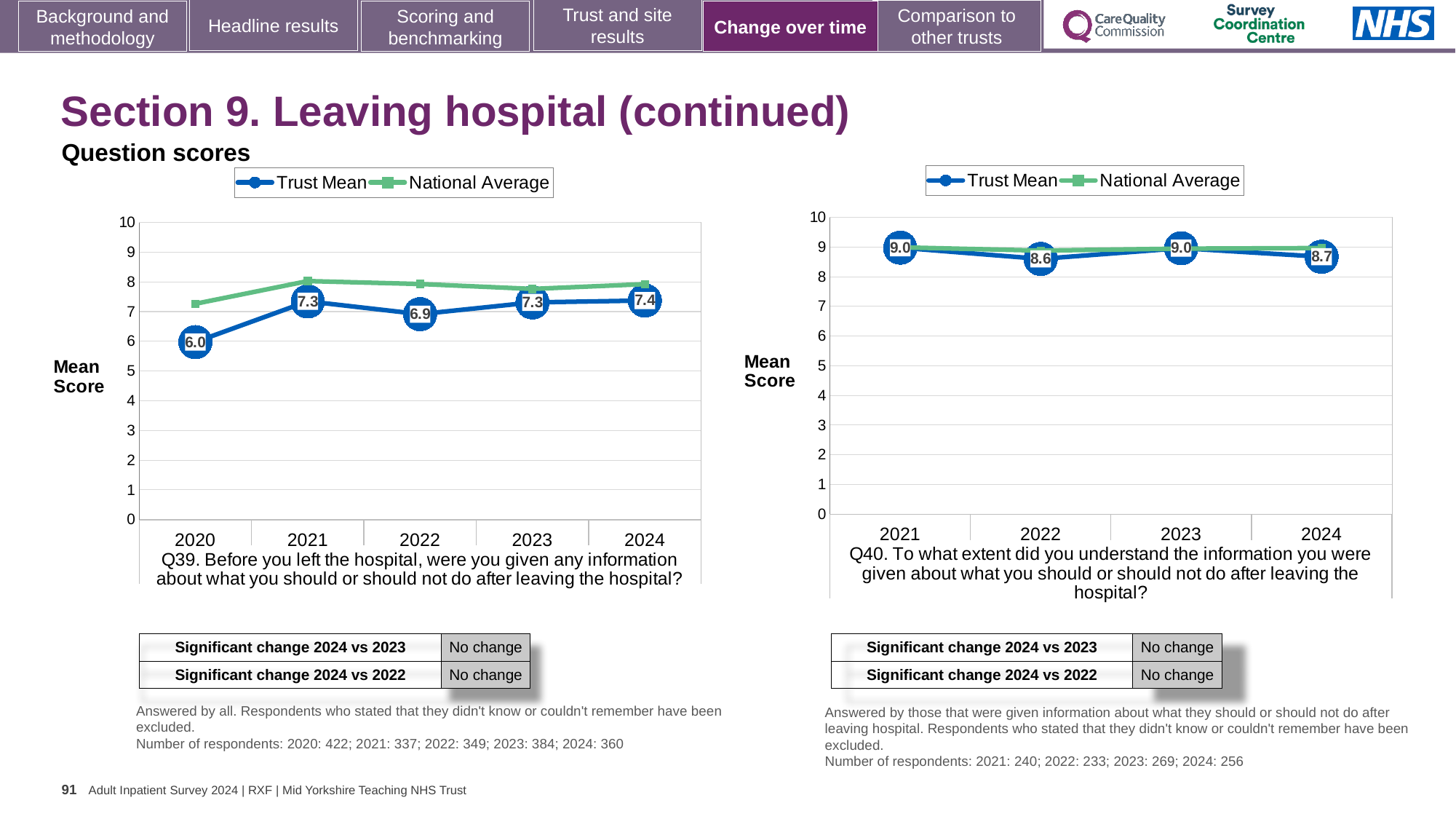
In the Q39 chart on the left, what is the Trust Mean score for 2020? 6.0 In the Q40 chart on the right, what is the Trust Mean score for 2024? 8.7 In the Q40 chart on the right, which is larger, the Trust Mean for 2023 or for 2022? 2023 In the Q39 chart on the left, is the National Average for 2020 greater or less than 6? greater In the Q40 chart on the right, what is the Trust Mean score for 2022? 8.6 In the Q39 chart on the left, which year has the lowest Trust Mean score? 2020 In the Q39 chart on the left, what is the Trust Mean score for 2024? 7.4 In the Q39 chart on the left, what is the difference between the Trust Mean scores for 2021 and 2020? 1.3 In the Q40 chart on the right, what is the difference between the Trust Mean scores for 2023 and 2022? 0.4 What type of chart is the Q39 chart on the left? Line chart How many series does the legend of the Q40 chart on the right list? 2 In the Q39 chart on the left, how many years are plotted on the x axis? 5